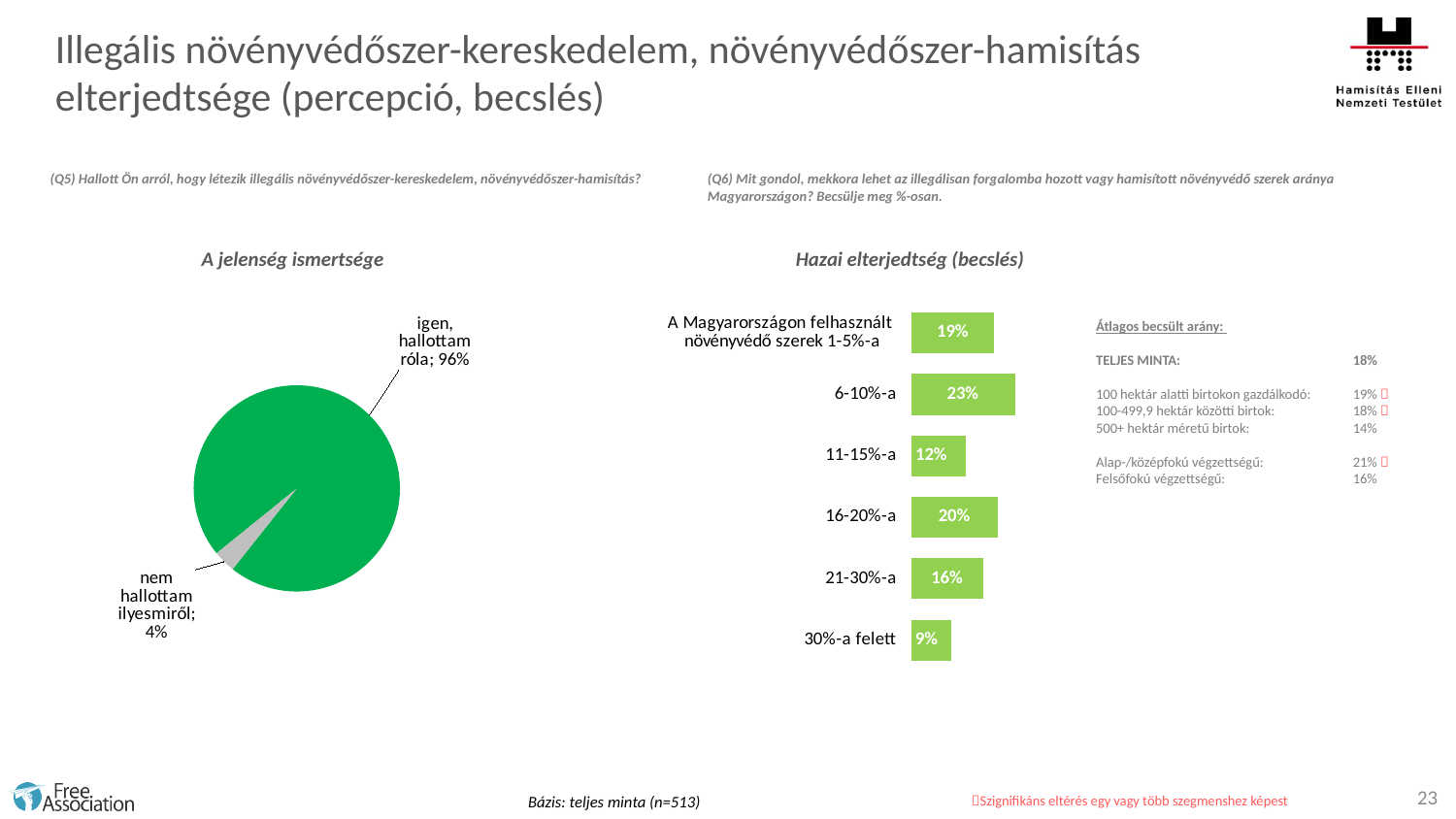
In the 'Hazai elterjedtség (becslés)' chart, what is the difference between the values for '6-10%-a' and '11-15%-a'? 11% In the 'Hazai elterjedtség (becslés)' chart, which is larger: the value for '21-30%-a' or the value for '11-15%-a'? 21-30%-a What kind of chart is 'Hazai elterjedtség (becslés)'? Bar chart In the 'Hazai elterjedtség (becslés)' chart, which category has the highest value? 6-10%-a What kind of chart is 'A jelenség ismertsége'? Pie chart How many categories does the 'Hazai elterjedtség (becslés)' chart show? 6 In the 'Hazai elterjedtség (becslés)' chart, what is the value for '16-20%-a'? 20% In the 'Hazai elterjedtség (becslés)' chart, which category has the lowest value? 30%-a felett In the 'Hazai elterjedtség (becslés)' chart, what is the value for '30%-a felett'? 9% In the 'Hazai elterjedtség (becslés)' chart, what is the value for '6-10%-a'? 23% In the 'A jelenség ismertsége' pie chart, what share is 'nem hallottam ilyesmiről'? 4% In the 'A jelenség ismertsége' pie chart, what share is 'igen, hallottam róla'? 96%